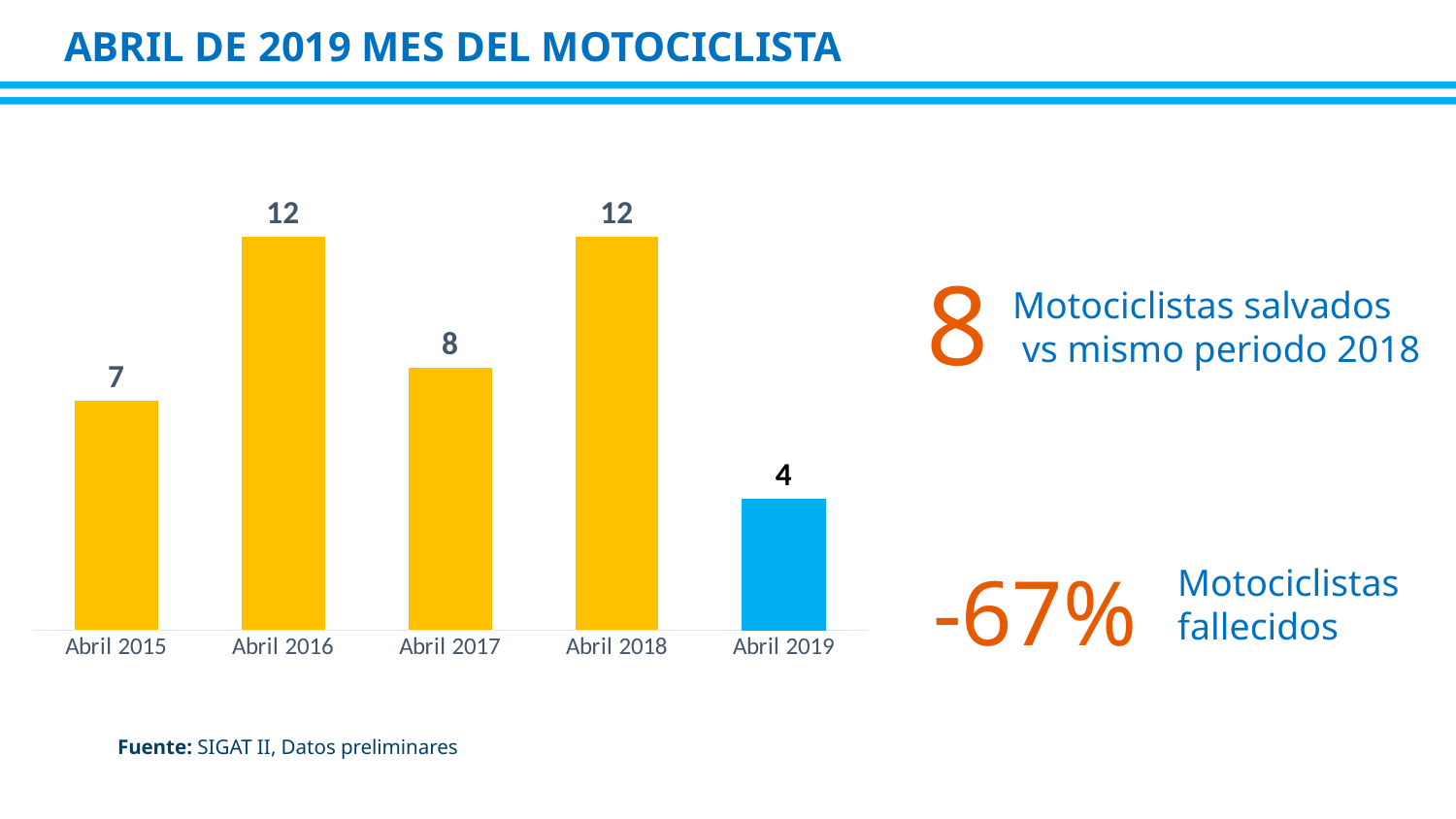
What is the difference between the values for Abril 2016 and Abril 2015? 5 Which bar is coloured differently from the others? Abril 2019 What kind of chart is shown on the slide? Bar chart How many categories are shown on the x axis? 5 What is the value for Abril 2015? 7 What is the value for Abril 2019? 4 Which two categories share the highest value of 12? Abril 2016 and Abril 2018 What is the value for Abril 2017? 8 What is the difference between the values for Abril 2018 and Abril 2019? 8 Do the values rise or fall from Abril 2018 to Abril 2019? Fall Which is larger, the value for Abril 2017 or the value for Abril 2015? Abril 2017 Which category has the lowest value? Abril 2019